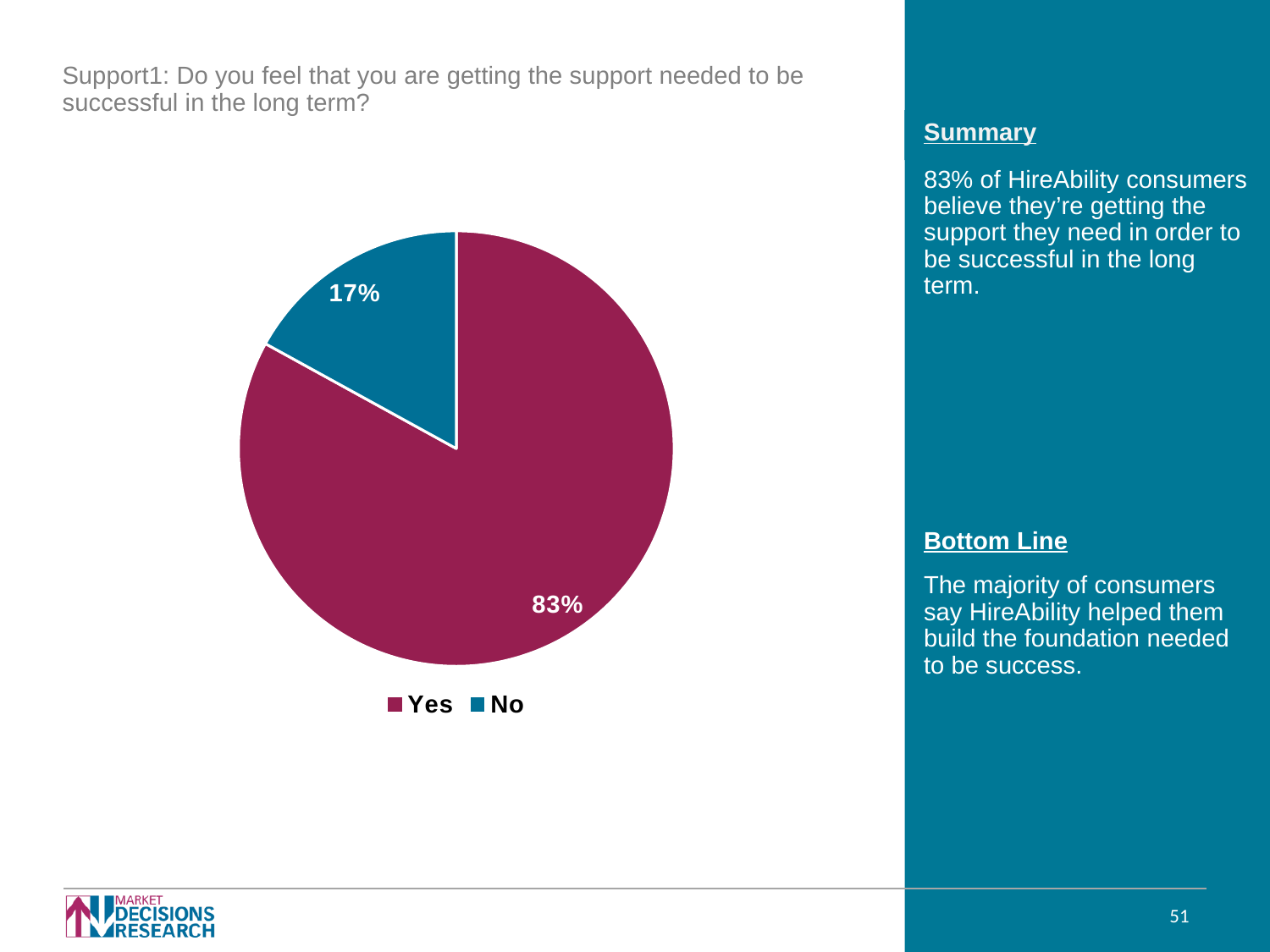
What kind of chart is shown on the slide? pie chart Which response has the smallest share of the pie? No How many entries does the legend list? 2 What share of the pie does the No slice represent? 17% What question does the chart report responses to? Do you feel that you are getting the support needed to be successful in the long term? What percentage of respondents answered Yes? 83% What colour is the Yes slice? magenta/maroon Which response has the largest share of the pie? Yes What is the difference in percentage points between the Yes and No slices? 66 Which slice is larger, Yes or No? Yes What percentage of respondents answered No? 17% How many slices does the pie chart have? 2